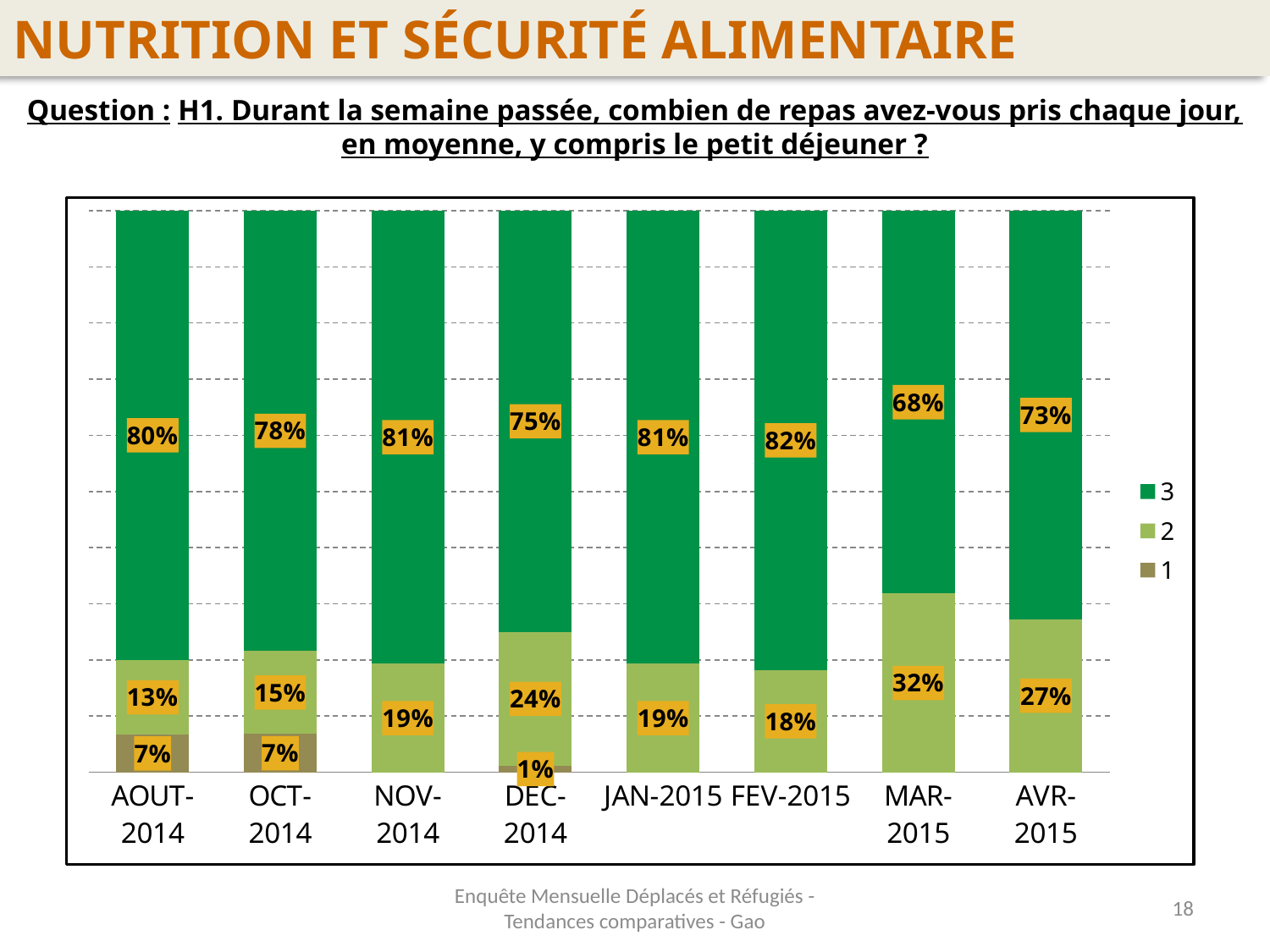
What is the value for series 1 in OCT-2014? 7% Which month has the highest value for series 3? FEV-2015 What is the value for series 2 in DEC-2014? 24% What is the difference between the series 3 value in AOUT-2014 and in MAR-2015? 12 percentage points How many series does the legend list? 3 What kind of chart is shown on the slide? Stacked bar chart How many months are shown on the x axis? 8 What is the value for series 3 in FEV-2015? 82% What is the total of the stacked bar for AOUT-2014? 100% Which month has the highest value for series 2? MAR-2015 Which is larger, the series 2 value in NOV-2014 or in DEC-2014? DEC-2014 Which month has the lowest value for series 3? MAR-2015